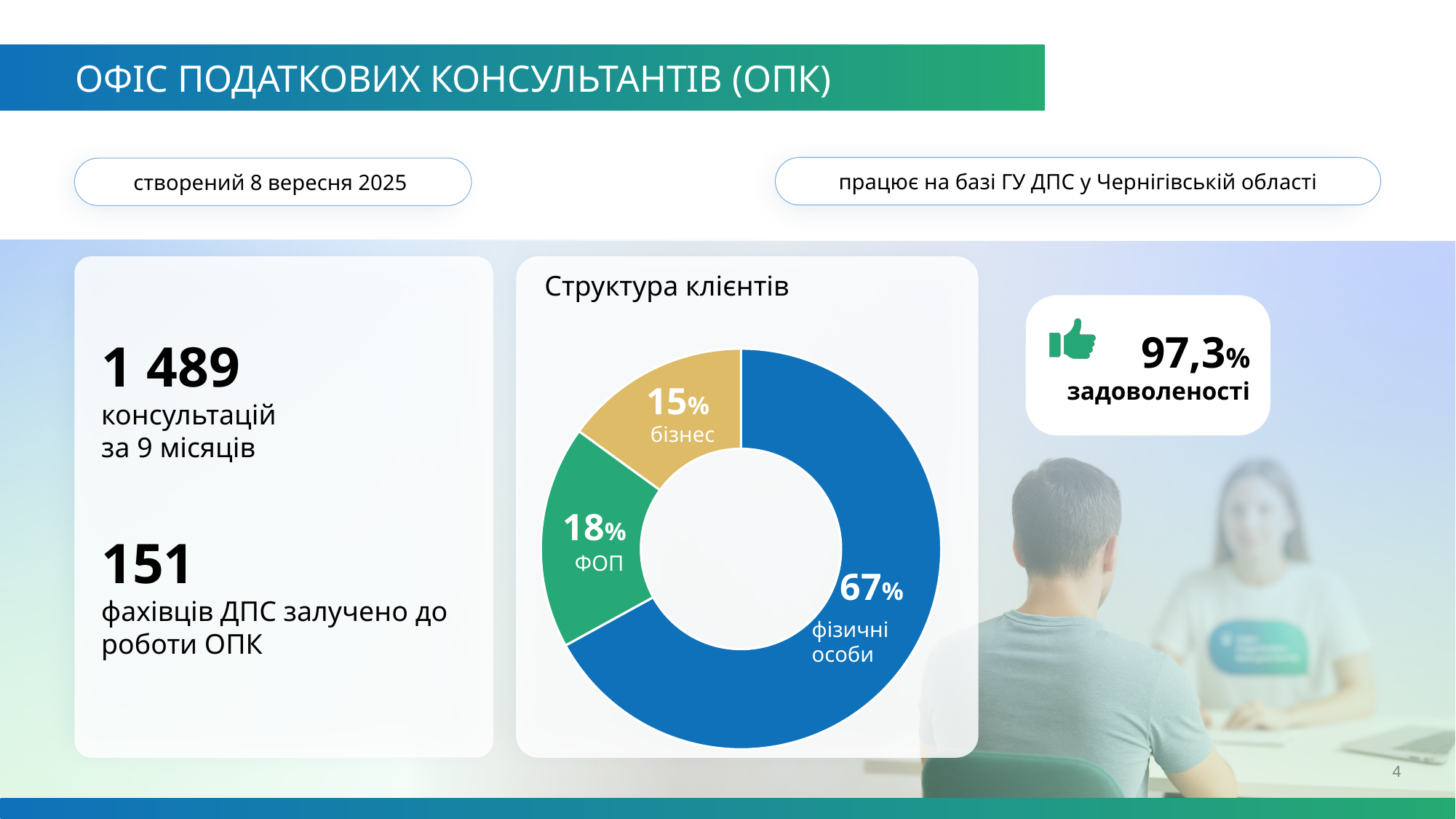
In the "Структура клієнтів" chart, what is the difference in percentage points between "фізичні особи" and "ФОП"? 49 What kind of chart is shown under the title "Структура клієнтів"? Pie chart (doughnut) What colour is the "ФОП" slice in the "Структура клієнтів" chart? Green In the "Структура клієнтів" chart, what is the difference in percentage points between "ФОП" and "бізнес"? 3 How many categories are shown in the "Структура клієнтів" chart? 3 Which category has the largest share in the "Структура клієнтів" chart? фізичні особи In the "Структура клієнтів" chart, which has a larger share: "ФОП" or "бізнес"? ФОП What is the share of "ФОП" in the "Структура клієнтів" chart? 18% Which category has the smallest share in the "Структура клієнтів" chart? бізнес What is the share of "бізнес" in the "Структура клієнтів" chart? 15% What is the share of "фізичні особи" in the "Структура клієнтів" chart? 67% What is the title of the pie chart on the slide? Структура клієнтів